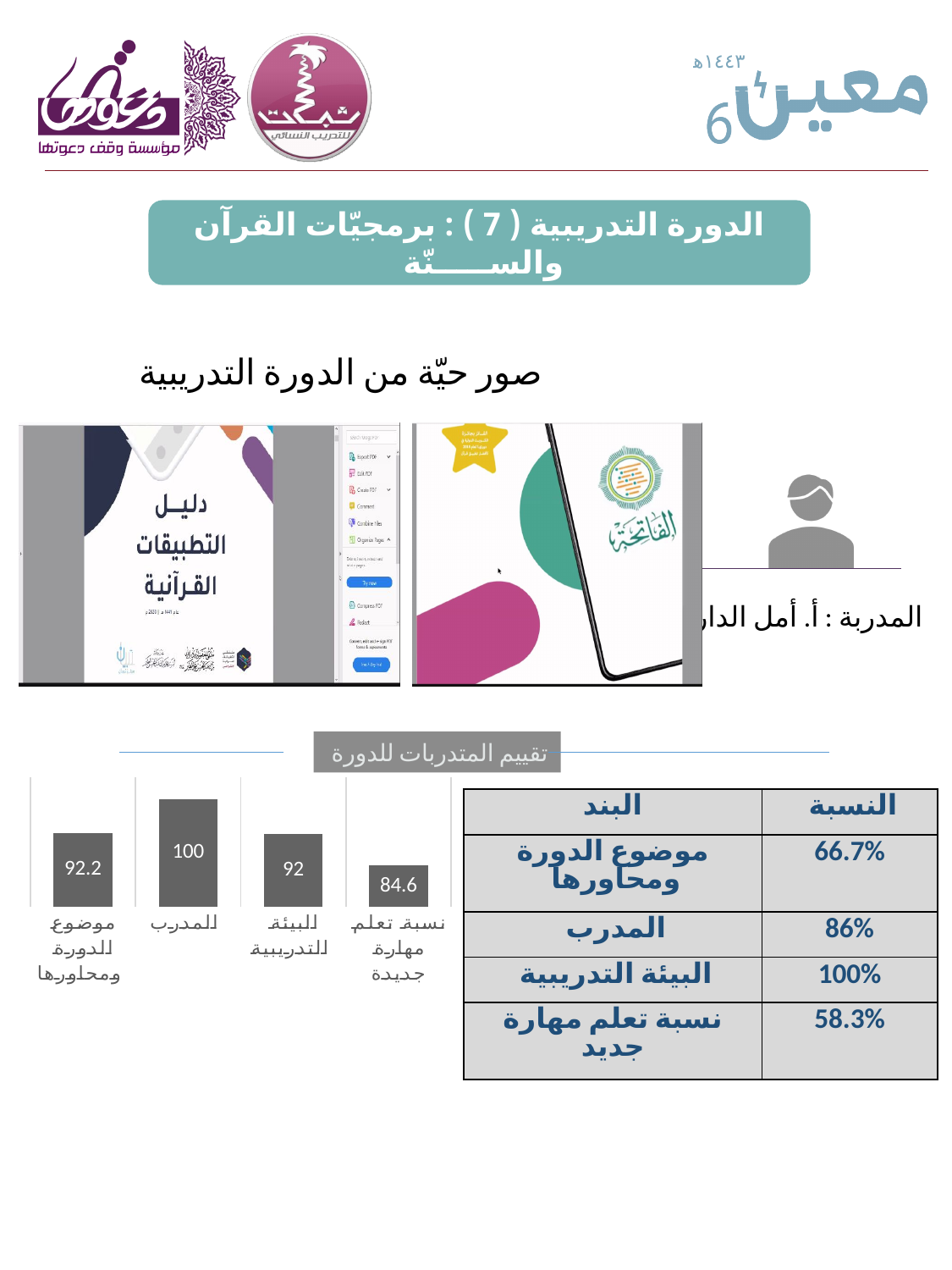
How many bars does the chart show? 4 What is the value for نسبة تعلم مهارة جديدة in the chart? 84.6 What is the value for المدرب in the chart? 100 What is the difference between the values for موضوع الدورة ومحاورها and البيئة التدريبية in the chart? 0.2 Which category has the highest value in the chart? المدرب What is the value for البيئة التدريبية in the chart? 92 Which category has the lowest value in the chart? نسبة تعلم مهارة جديدة What is the difference between the values for المدرب and نسبة تعلم مهارة جديدة in the chart? 15.4 What is the value for موضوع الدورة ومحاورها in the chart? 92.2 What type of chart is shown on the slide? bar chart Which is larger in the chart, the value for المدرب or the value for البيئة التدريبية? المدرب What colour are the bars in the chart? grey